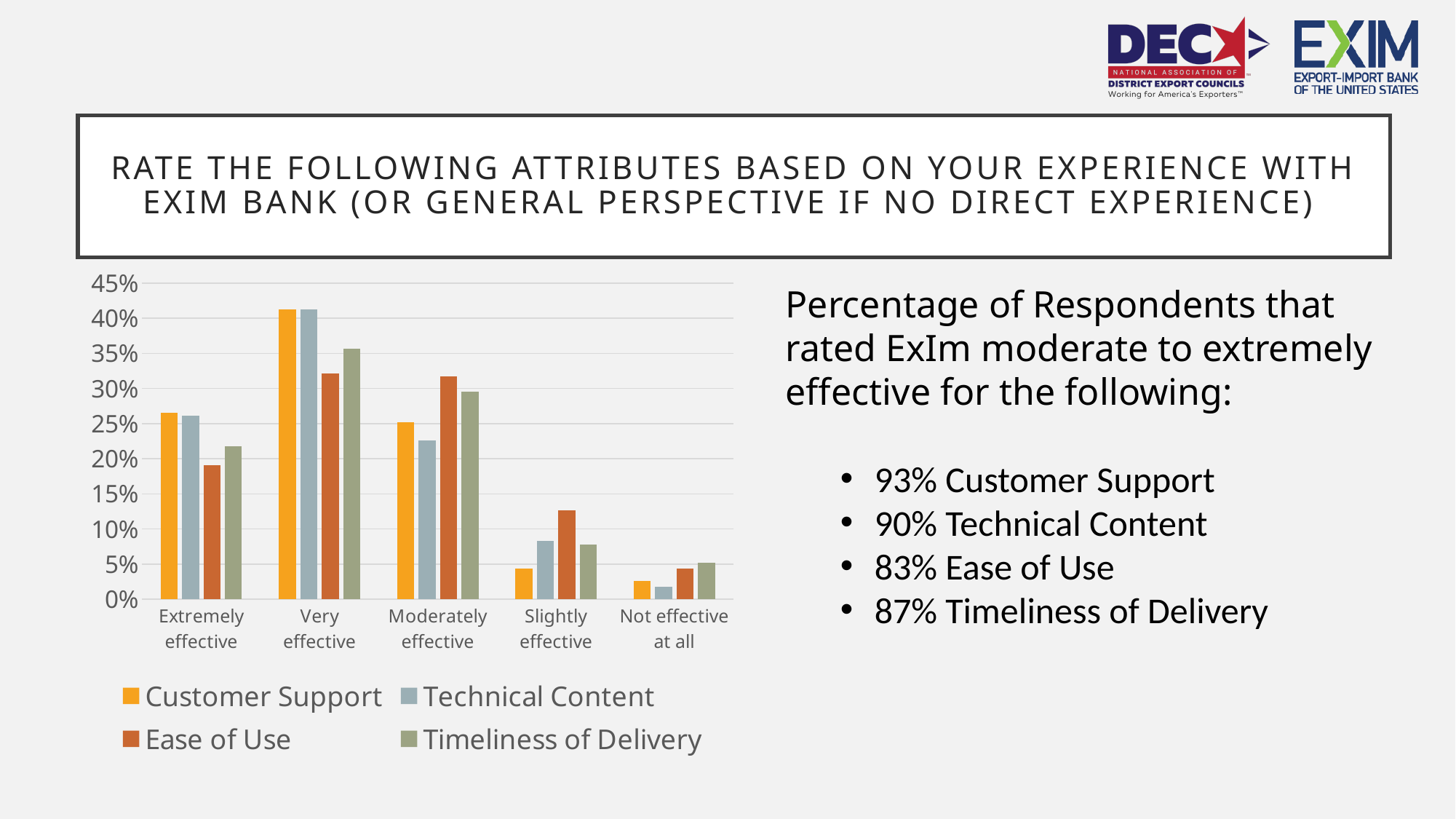
How many rating categories are shown along the x axis of the chart? 5 Which series has the highest bar in the Moderately effective category? Ease of Use Which series has the lowest bar in the Not effective at all category? Technical Content How many series does the chart's legend list? 4 Is the Customer Support value for Very effective greater or less than 40%? greater Do the Customer Support values rise or fall from Very effective to Not effective at all? Fall What kind of chart is shown on the slide? Bar chart In which category does Customer Support reach its highest value? Very effective In the Slightly effective category, which is larger: Customer Support or Ease of Use? Ease of Use Is the Ease of Use value for Slightly effective greater or less than 10%? greater Is the Ease of Use value for Extremely effective greater or less than 20%? less In the Very effective category, which is larger: Ease of Use or Timeliness of Delivery? Timeliness of Delivery